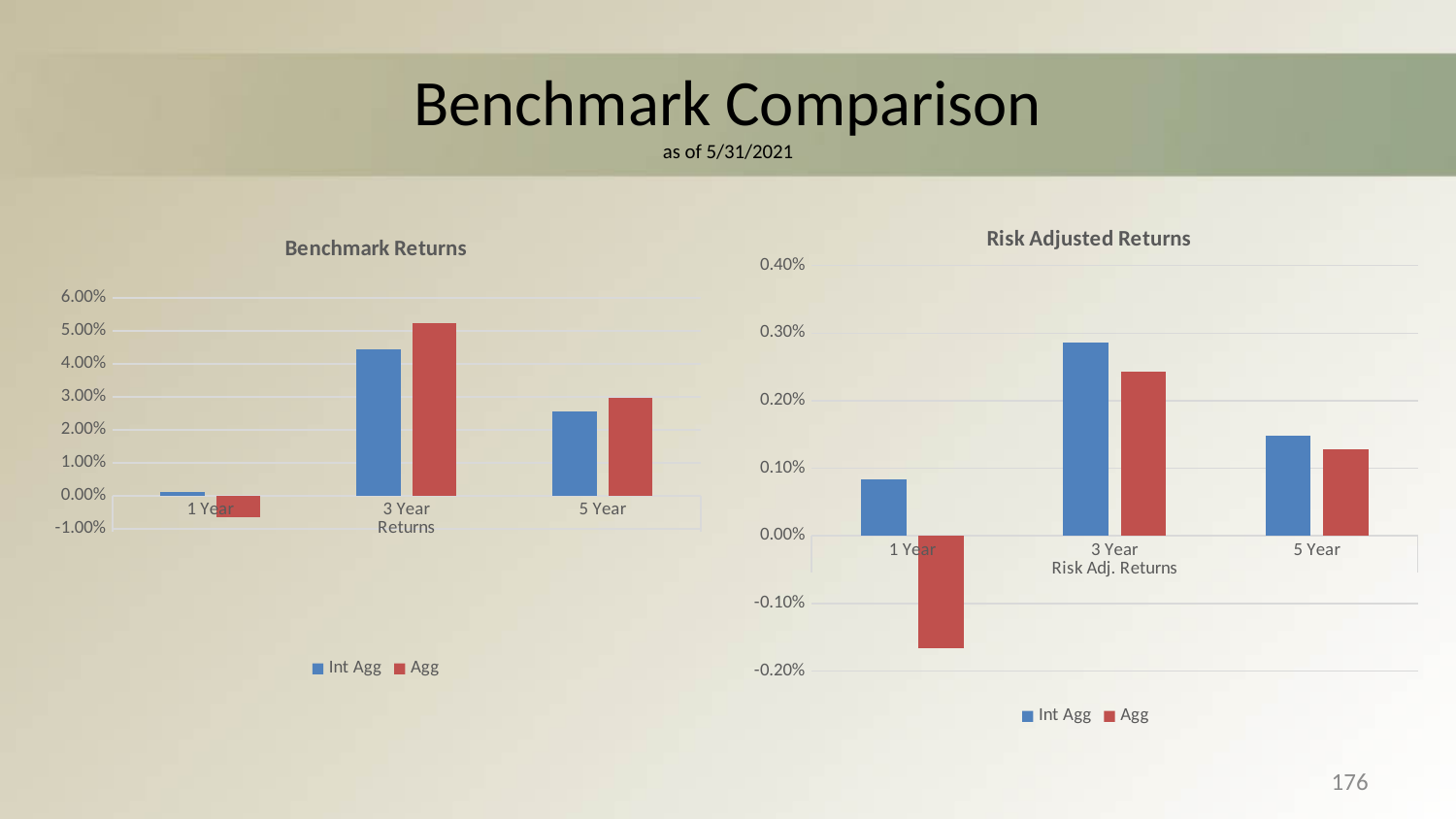
In the Benchmark Returns chart, which category has the lowest Int Agg value? 1 Year In the Risk Adjusted Returns chart, is the Int Agg value for 3 Year greater or less than 0.20%? greater What kind of chart is the Benchmark Returns chart? bar chart In the Benchmark Returns chart, which category has the highest Agg value? 3 Year In the Benchmark Returns chart, which is larger for 3 Year, Int Agg or Agg? Agg How many categories are shown on the x axis of the Benchmark Returns chart? 3 In the Benchmark Returns chart, is the Int Agg value for 5 Year greater or less than 3.00%? less In the Risk Adjusted Returns chart, which category has the lowest Agg value? 1 Year What are the two legend entries in the Benchmark Returns chart? Int Agg and Agg In the Benchmark Returns chart, is the Agg value for 3 Year greater or less than 5.00%? greater How many series does the legend of the Risk Adjusted Returns chart list? 2 In the Risk Adjusted Returns chart, which is larger for 1 Year, Int Agg or Agg? Int Agg